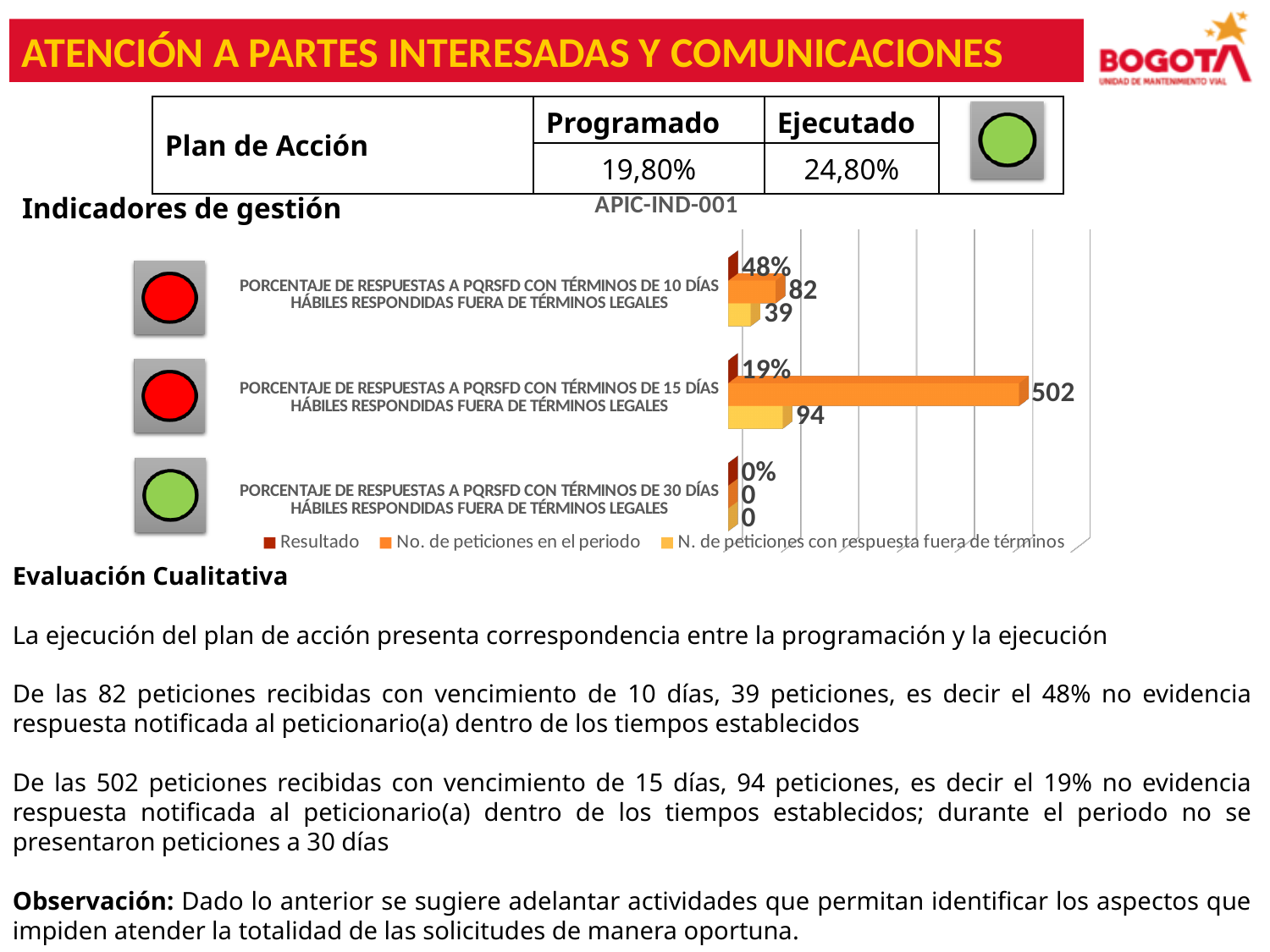
In the APIC-IND-001 chart, what is the 'Resultado' value for the 30 días hábiles category? 0% In the APIC-IND-001 chart, what is the difference between 'No. de peticiones en el periodo' for the 15 días category and for the 10 días category? 420 In the APIC-IND-001 chart, which category has the highest value for 'No. de peticiones en el periodo'? PORCENTAJE DE RESPUESTAS A PQRSFD CON TÉRMINOS DE 15 DÍAS HÁBILES RESPONDIDAS FUERA DE TÉRMINOS LEGALES In the APIC-IND-001 chart, what is the value of 'No. de peticiones en el periodo' for the 15 días hábiles category? 502 In the APIC-IND-001 chart, which is larger: 'N. de peticiones con respuesta fuera de términos' for the 10 días category or for the 15 días category? 15 días category How many series does the legend of the APIC-IND-001 chart list? 3 In the APIC-IND-001 chart, what is the value of 'N. de peticiones con respuesta fuera de términos' for the 15 días hábiles category? 94 How many categories are plotted in the APIC-IND-001 chart? 3 In the APIC-IND-001 chart, which category has the highest 'Resultado' value? PORCENTAJE DE RESPUESTAS A PQRSFD CON TÉRMINOS DE 10 DÍAS HÁBILES RESPONDIDAS FUERA DE TÉRMINOS LEGALES What kind of chart is shown under the title APIC-IND-001? bar chart In the APIC-IND-001 chart, what is the difference between 'No. de peticiones en el periodo' and 'N. de peticiones con respuesta fuera de términos' for the 10 días category? 43 In the APIC-IND-001 chart, what is the 'Resultado' value for the 10 días hábiles category? 48%